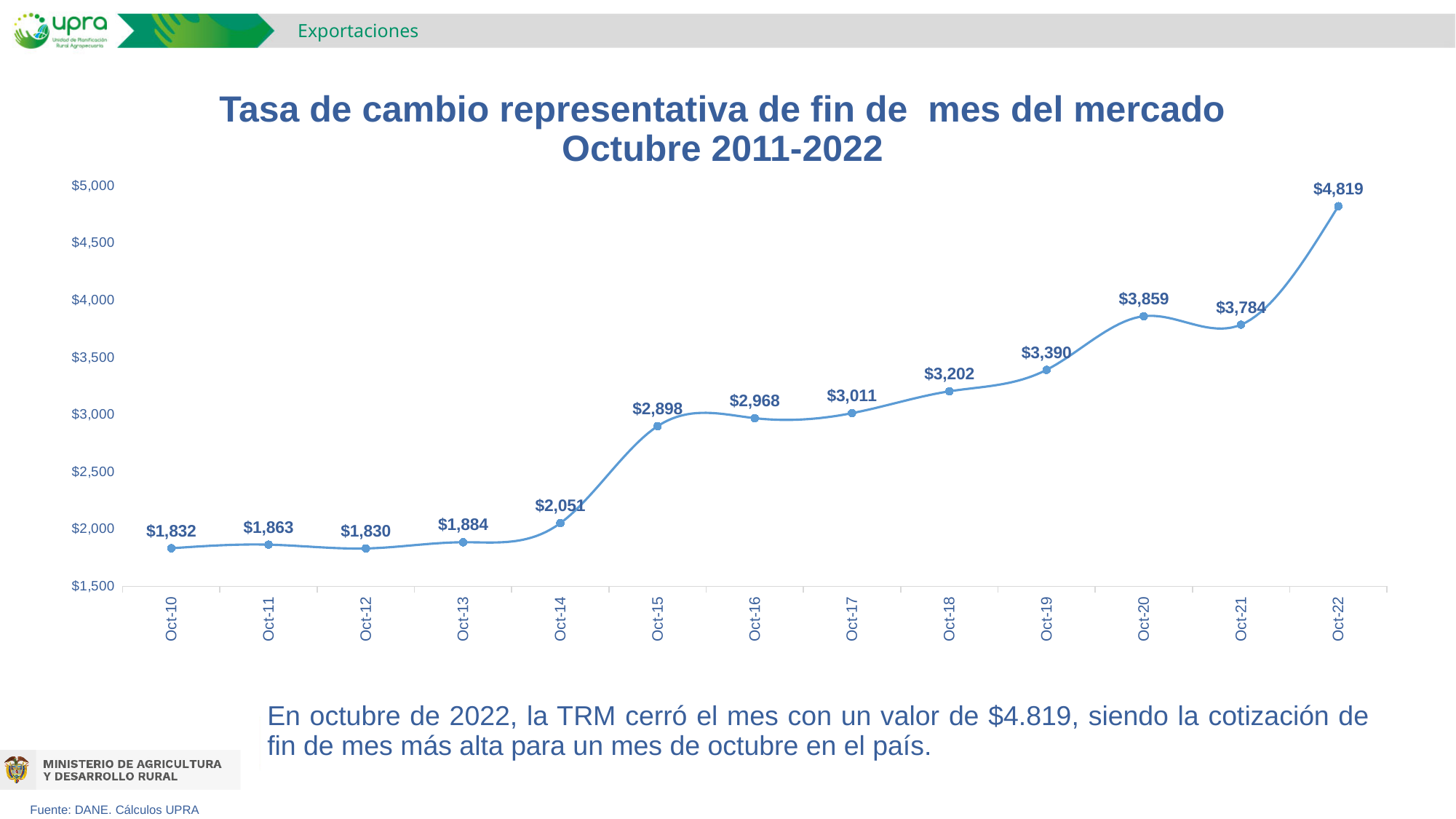
Which month has the highest value? Oct-22 Which is larger, the value for Oct-20 or the value for Oct-21? Oct-20 Which month has the lowest value? Oct-12 Do the values generally rise or fall from Oct-10 to Oct-22? rise What is the difference between the values for Oct-22 and Oct-21? $1,035 What is the value for Oct-22? $4,819 What is the value for Oct-15? $2,898 How many data points are plotted on the chart? 13 What is the difference between the values for Oct-15 and Oct-14? $847 Is the value for Oct-19 greater or less than $3,500? less What is the value for Oct-20? $3,859 What kind of chart is shown on the slide? line chart